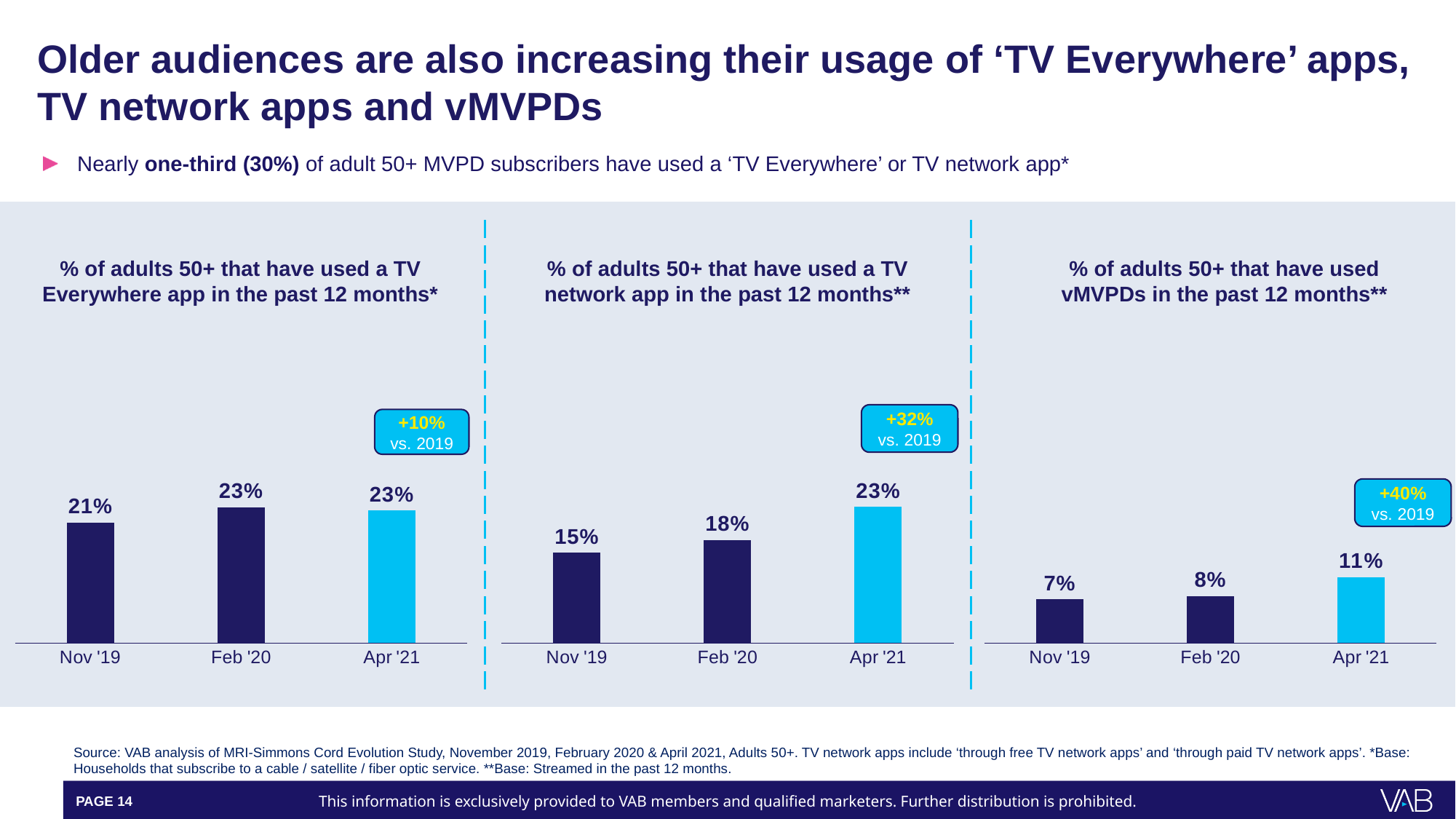
In the right chart (vMVPDs), what is the difference between the Apr '21 and Feb '20 values? 3 percentage points In the middle chart (TV network app), what is the difference between the Apr '21 and Nov '19 values? 8 percentage points In the right chart (vMVPDs), which period has the highest value? Apr '21 In the middle chart (% of adults 50+ that have used a TV network app in the past 12 months), what is the value for Apr '21? 23% What kind of chart is the right chart (vMVPDs)? Bar chart In the left chart (TV Everywhere app), which is larger: the value for Nov '19 or the value for Feb '20? Feb '20 How many periods are shown on the x axis of the middle chart (TV network app)? 3 What percentage change vs. 2019 is shown in the callout on the right chart (vMVPDs)? +40% In the left chart (% of adults 50+ that have used a TV Everywhere app in the past 12 months), what is the value for Nov '19? 21% In the middle chart (TV network app), which period has the lowest value? Nov '19 In the middle chart (TV network app), do the values rise or fall from Nov '19 to Apr '21? Rise In the right chart (% of adults 50+ that have used vMVPDs in the past 12 months), what is the value for Feb '20? 8%